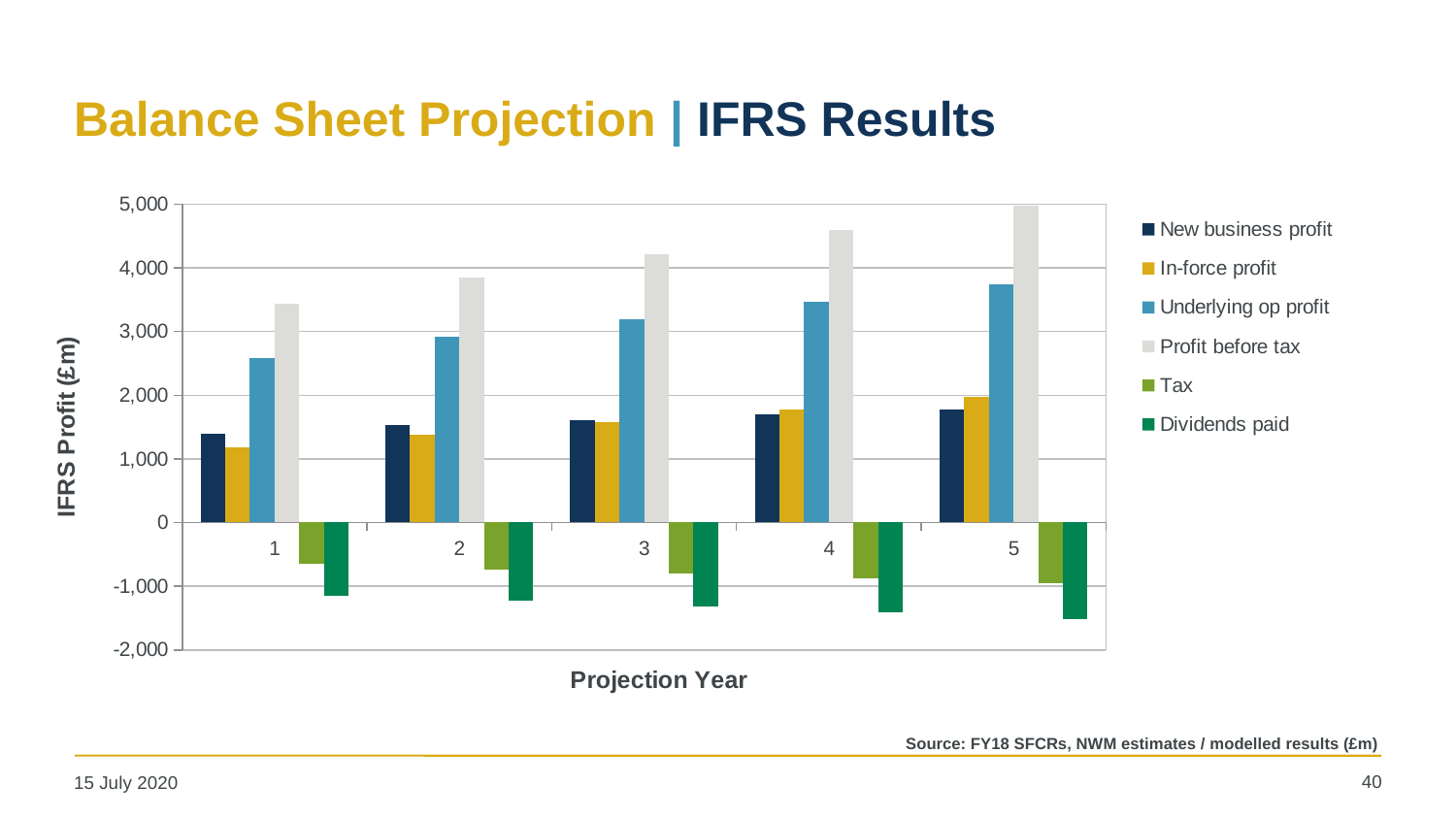
In projection year 5, which is larger: New business profit or In-force profit? In-force profit How many projection years are shown on the x axis? 5 What kind of chart is shown on the slide? bar chart Is the value for Underlying op profit in projection year 1 greater or less than 3,000? less Which series has the lowest value in projection year 1? Dividends paid Is the value for Profit before tax in projection year 1 greater or less than 3,000? greater Is the value for Dividends paid in projection year 5 greater or less than -1,000? less What is the title of the y axis? IFRS Profit (£m) How many series does the legend list? 6 In projection year 1, which is larger: New business profit or In-force profit? New business profit In which projection year is Profit before tax highest? 5 Does Profit before tax rise or fall from projection year 1 to year 5? rise